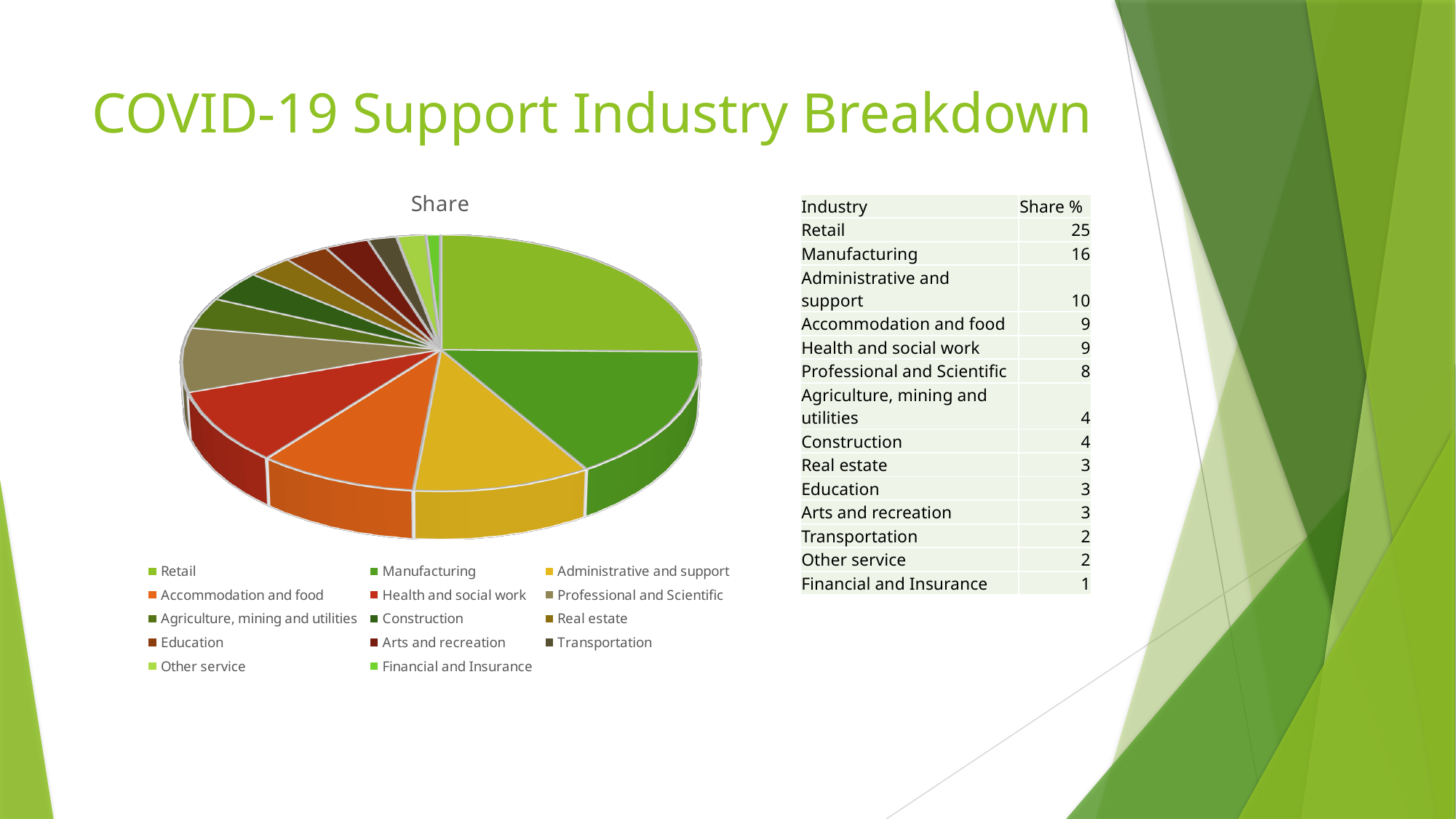
How many categories does the pie chart have? 14 Which industry has the largest share in the pie chart? Retail What is the title of the chart? Share What is the difference in share % between Retail and Manufacturing? 9 What kind of chart is shown on the slide? Pie chart What is the share % for Professional and Scientific? 8 What is the combined share % of Real estate, Education and Arts and recreation? 9 Which has a larger share, Accommodation and food or Construction? Accommodation and food What is the share % for Manufacturing? 16 Which industry has the smallest share in the pie chart? Financial and Insurance What is the share % for Transportation? 2 What is the share % for Administrative and support? 10